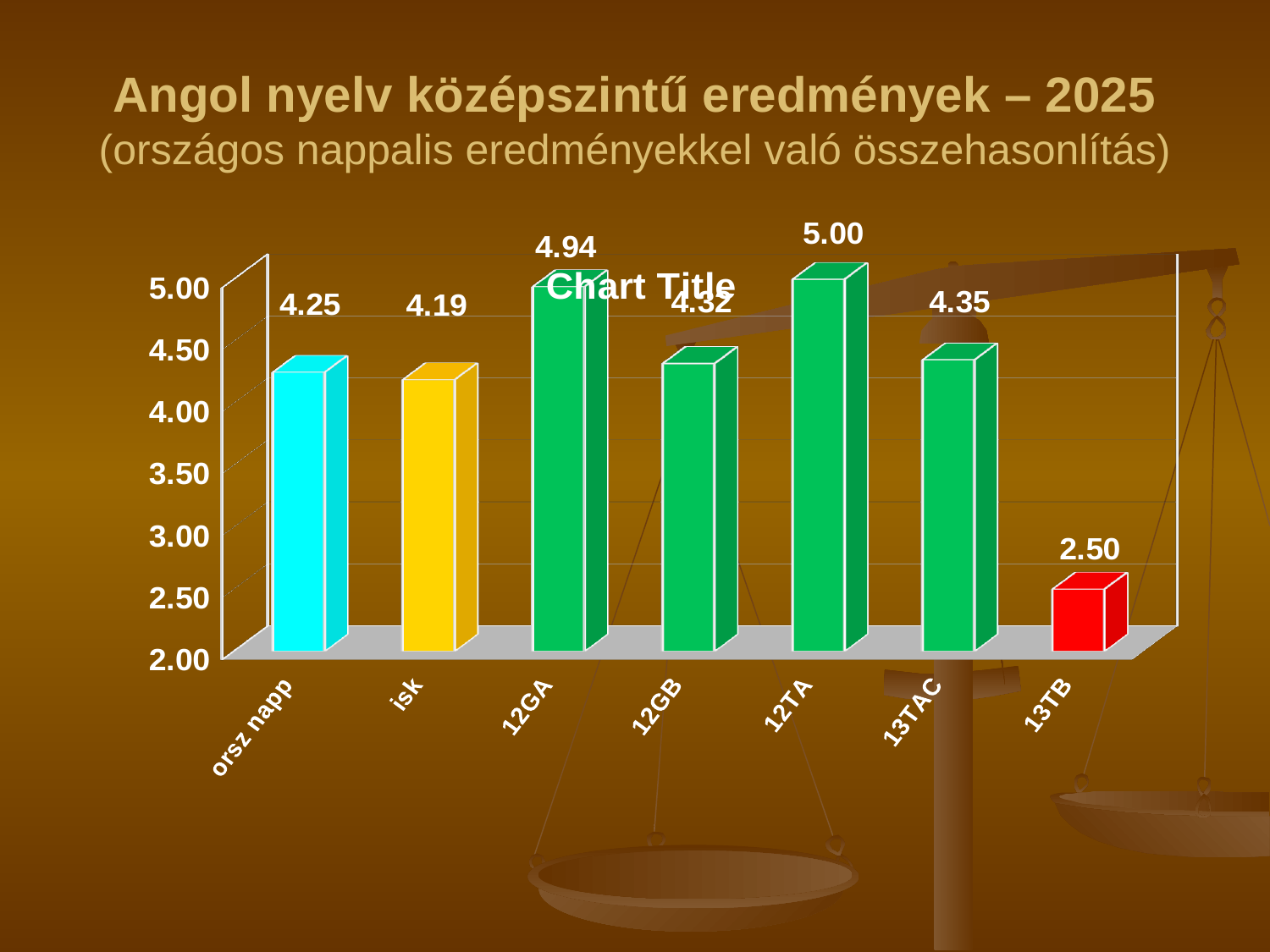
What colour is the bar for 13TB? red Which category has the lowest value? 13TB What kind of chart is shown on the slide? bar chart What is the value for isk? 4.19 What is the value for orsz napp? 4.25 Which category has the highest value? 12TA Which is larger, the value for 13TAC or the value for isk? 13TAC What is the value for 12GA? 4.94 How many categories are shown on the x axis? 7 What is the value for 13TB? 2.50 What is the difference between the values for 12GA and 12GB? 0.62 What is the difference between the values for 12TA and 13TB? 2.50